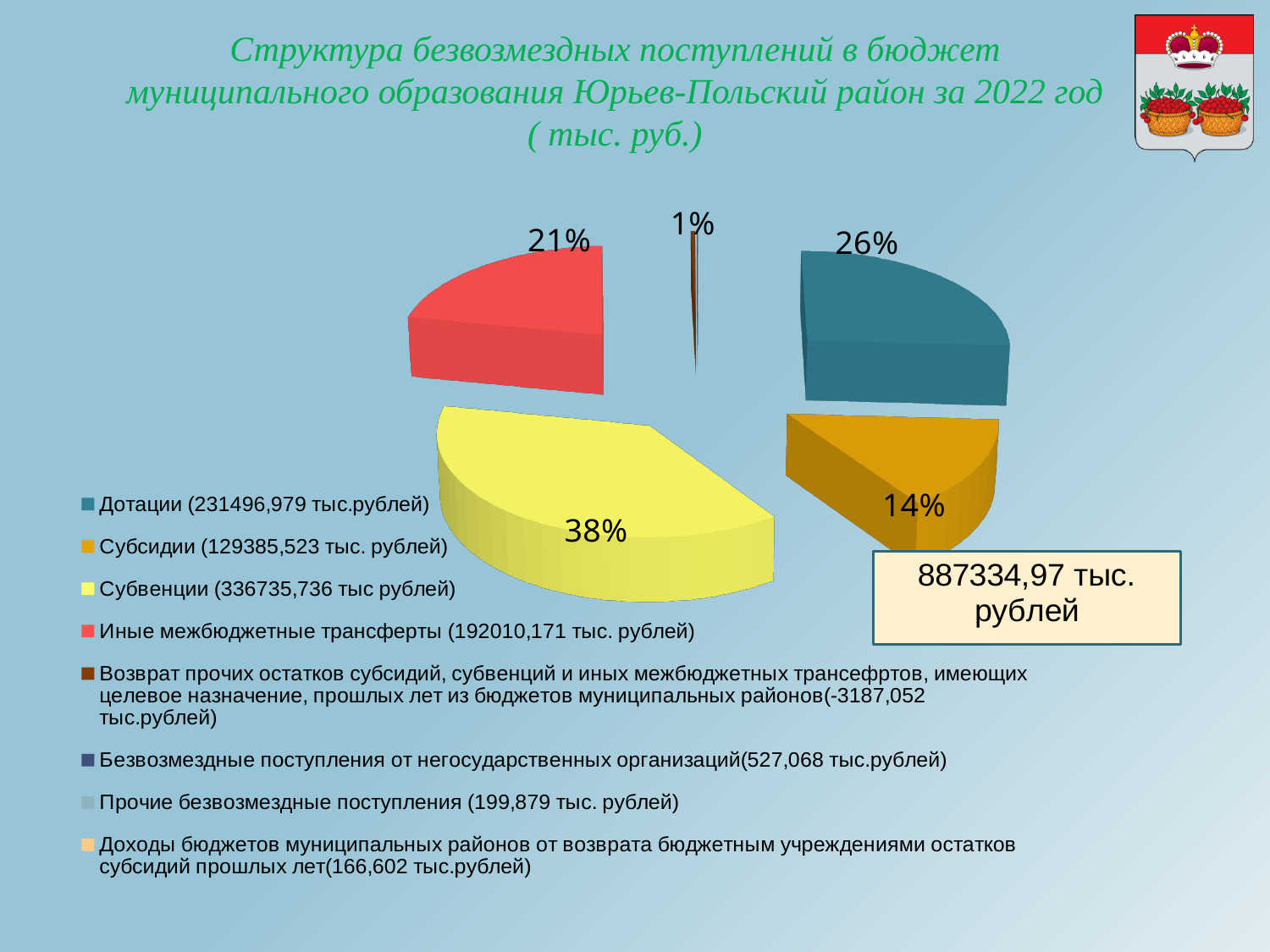
What total amount is shown in the box next to the pie chart? 887334,97 тыс. рублей What percentage of the pie is labelled for Субвенции? 38% Which category has the largest slice of the pie? Субвенции What is the smallest percentage label shown on the pie? 1% By how many percentage points does the Субвенции slice exceed the Субсидии slice? 24 percentage points According to the legend, what amount is given for Дотации? 231496,979 тыс.рублей Which slice is larger: Дотации or Иные межбюджетные трансферты? Дотации What kind of chart is shown on the slide? pie chart What percentage of the pie is labelled for Дотации? 26% How many entries does the legend list? 8 What percentage of the pie is labelled for Субсидии? 14% What percentage of the pie is labelled for Иные межбюджетные трансферты? 21%